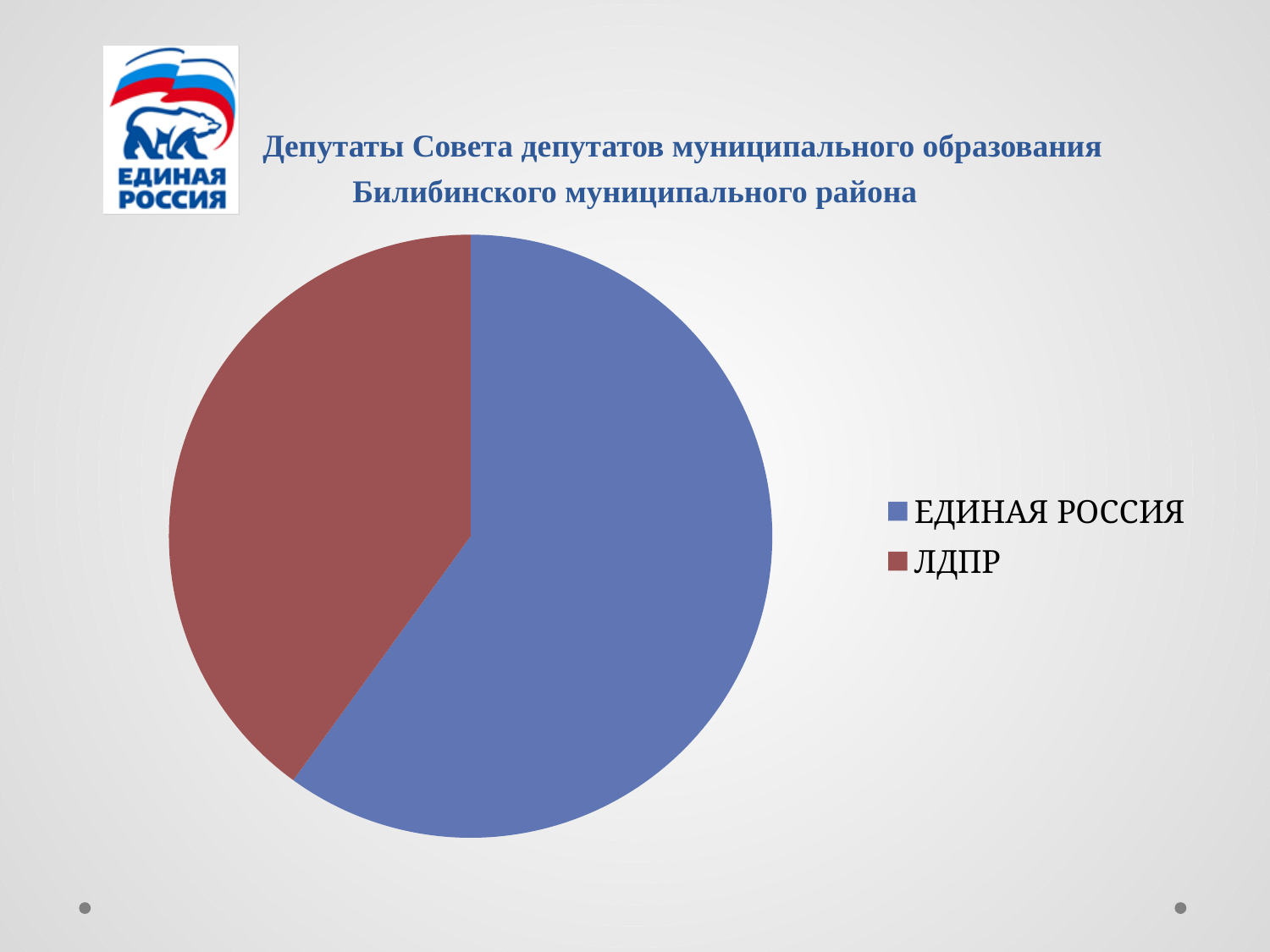
Which party has the smallest slice of the pie chart? ЛДПР What colour is the slice for ЛДПР in the pie chart? red How many slices does the pie chart have? 2 Which party is represented by the blue slice in the pie chart? ЕДИНАЯ РОССИЯ What kind of chart is shown on the slide? pie chart Does ЛДПР have a larger or smaller slice than ЕДИНАЯ РОССИЯ? smaller Which party has the largest slice of the pie chart? ЕДИНАЯ РОССИЯ How many entries does the legend of the pie chart list? 2 Which slice is larger, ЕДИНАЯ РОССИЯ or ЛДПР? ЕДИНАЯ РОССИЯ